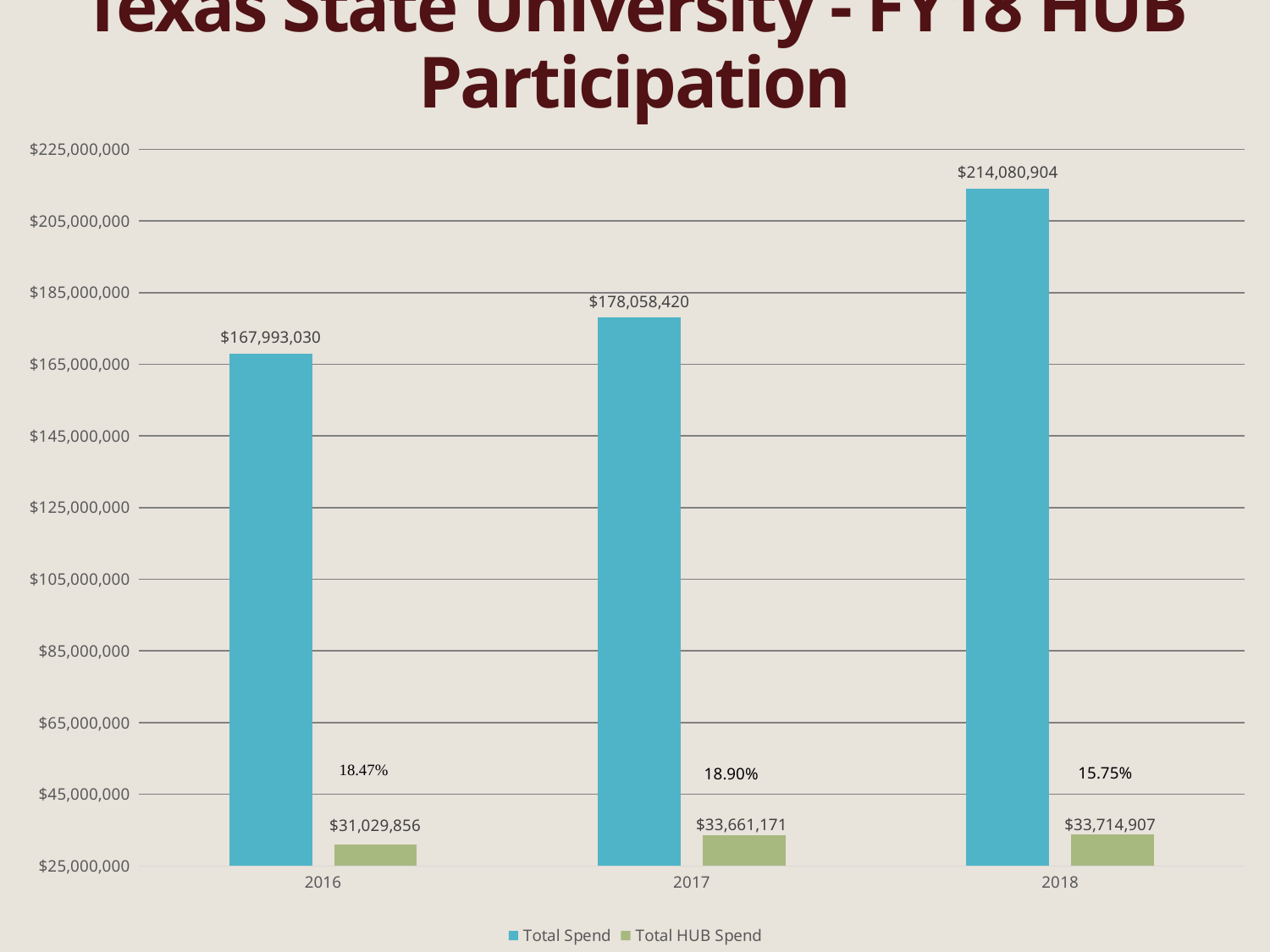
What is the difference between the Total HUB Spend in 2017 and in 2016? $2,631,315 How many series does the legend list? 2 Does the Total Spend rise or fall from 2016 to 2018? Rise What type of chart is shown on the slide? Bar chart Is the Total Spend for 2016 greater or less than $165,000,000? greater What is the Total Spend for 2018? $214,080,904 What is the Total Spend for 2017? $178,058,420 Which year has the highest Total Spend? 2018 What HUB participation percentage is shown for 2017? 18.90% Which year has the lowest Total HUB Spend? 2016 What is the Total HUB Spend for 2016? $31,029,856 What is the difference between the Total Spend in 2018 and in 2017? $36,022,484